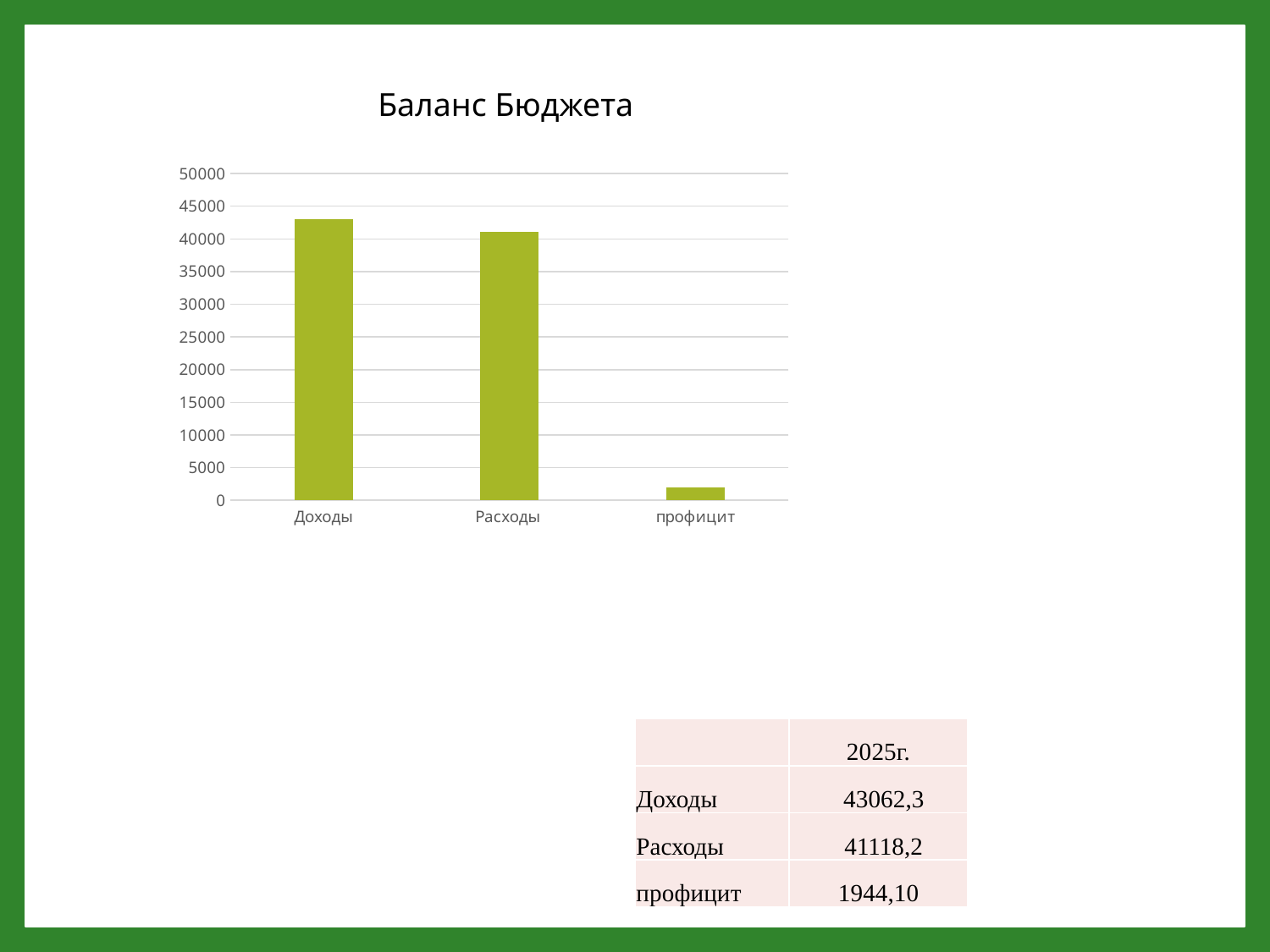
According to the table on the slide, what is the value for Расходы in 2025г.? 41118,2 Is the value for Расходы greater or less than 35000? greater According to the table on the slide, what is the value for Доходы in 2025г.? 43062,3 How many categories are plotted on the x axis of the chart? 3 Which category has the lowest bar in the chart? профицит Is the value for Доходы greater or less than 40000? greater What is the title of the chart? Баланс Бюджета According to the table on the slide, what is the value for профицит in 2025г.? 1944,10 Which category has the highest bar in the chart? Доходы Is the value for профицит greater or less than 5000? less Which is larger in the chart, Доходы or Расходы? Доходы What kind of chart is shown on the slide? bar chart